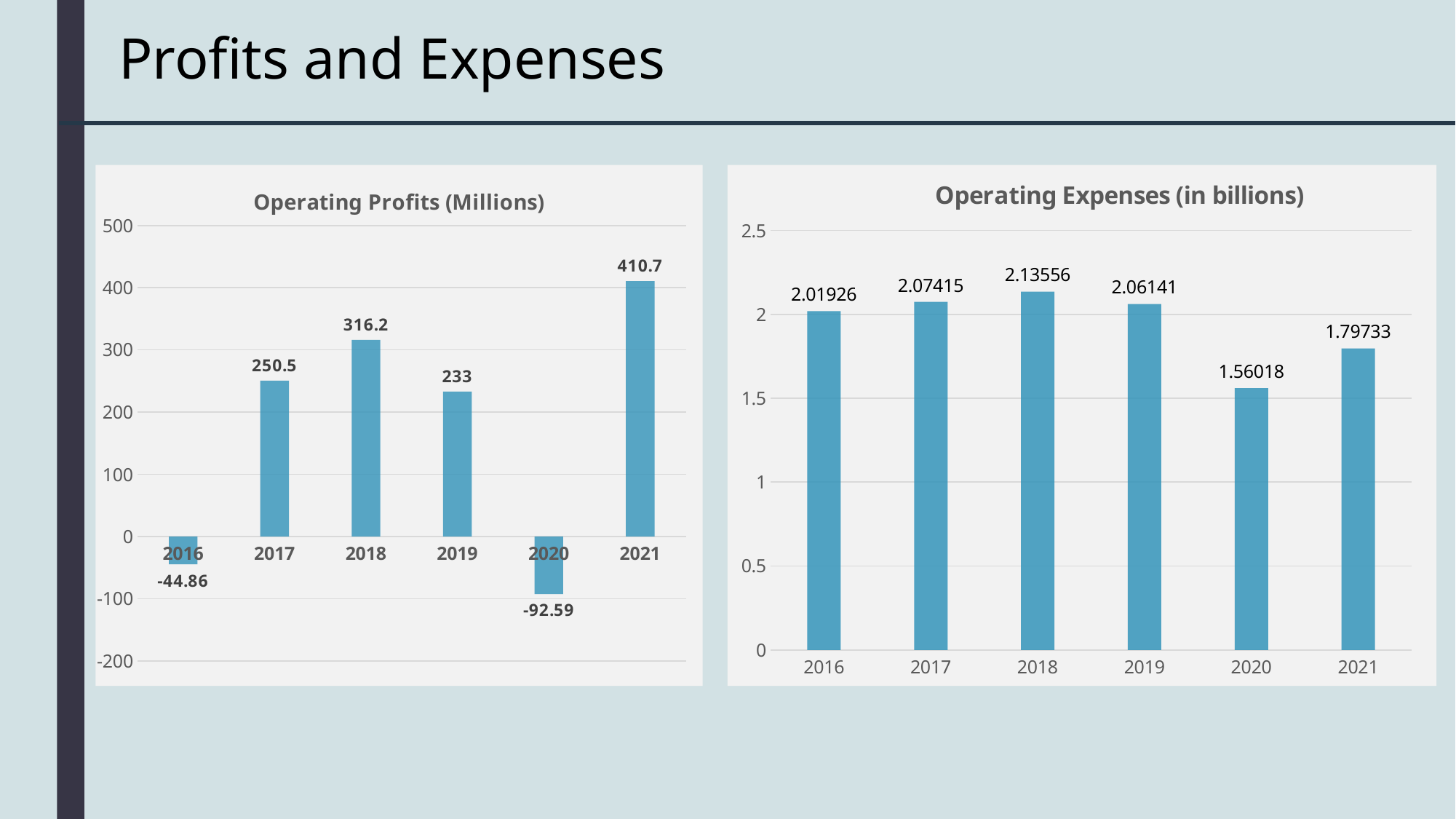
In the Operating Expenses (in billions) chart, what is the value for 2019? 2.06141 In the Operating Expenses (in billions) chart, which year has the lowest value? 2020 In the Operating Expenses (in billions) chart, which year has the highest value? 2018 What kind of chart is the Operating Expenses (in billions) chart? bar chart In the Operating Expenses (in billions) chart, which is larger, the value for 2017 or the value for 2021? 2017 In the Operating Expenses (in billions) chart, do the values rise or fall from 2019 to 2020? fall In the Operating Profits (Millions) chart, which year has the highest value? 2021 In the Operating Profits (Millions) chart, what is the value for 2018? 316.2 In the Operating Profits (Millions) chart, how many years are shown? 6 In the Operating Profits (Millions) chart, which year has the lowest value? 2020 In the Operating Profits (Millions) chart, what is the value for 2020? -92.59 In the Operating Profits (Millions) chart, what is the difference between the values for 2021 and 2019? 177.7